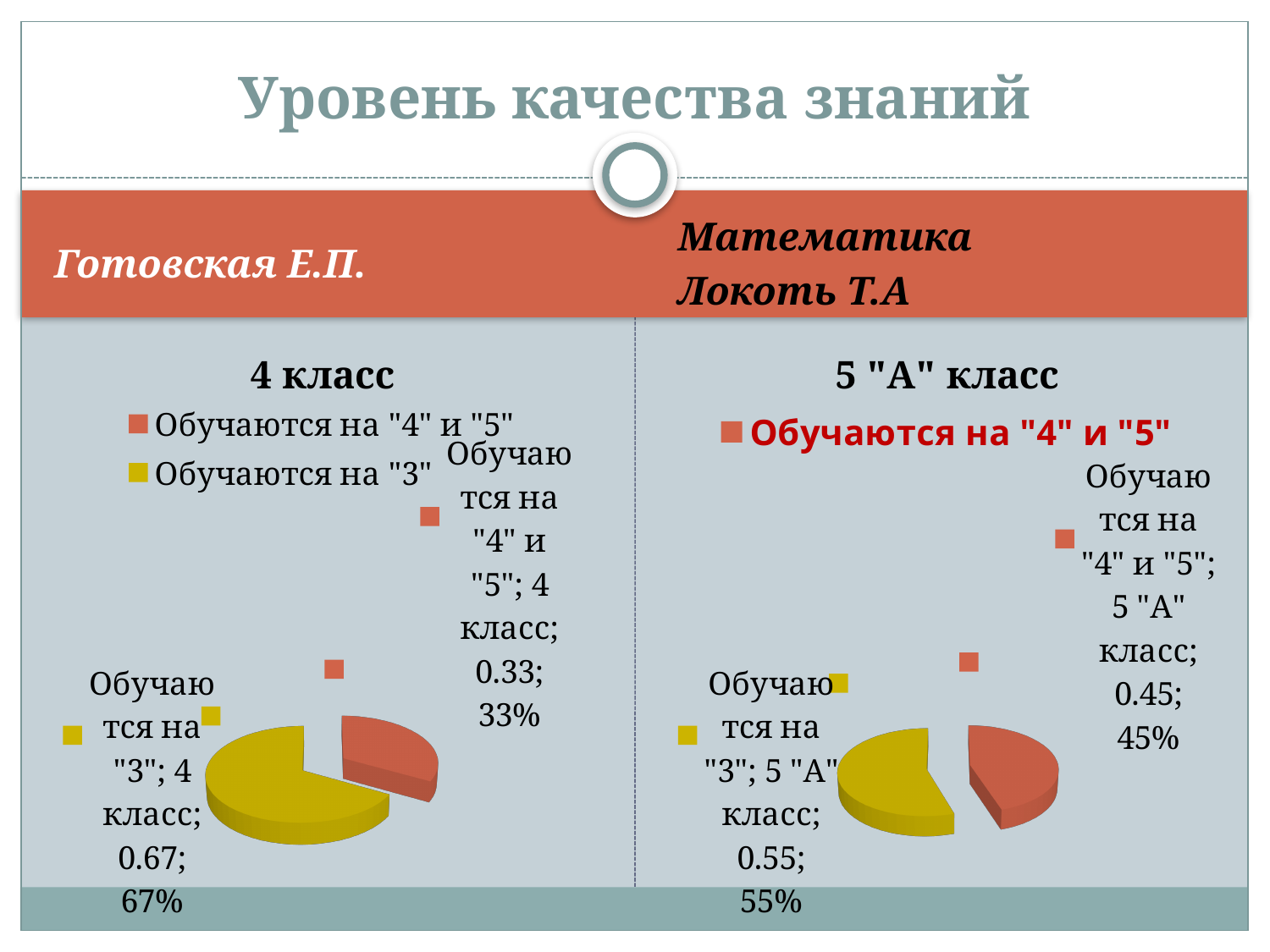
In the "5 "А" класс" chart, what share of the pie is labelled for Обучаются на "4" и "5"? 45% In the "5 "А" класс" chart, which slice is the smallest? Обучаются на "4" и "5" In the "4 класс" chart, what share of the pie is labelled for Обучаются на "4" и "5"? 33% In the "4 класс" chart, what is the difference in percentage points between the Обучаются на "3" slice and the Обучаются на "4" и "5" slice? 34% In the "4 класс" chart, what value is shown for Обучаются на "3"? 0.67 In the "4 класс" chart, what colour is the Обучаются на "3" slice? yellow How many slices does the "5 "А" класс" pie chart have? 2 What kind of chart is the "4 класс" chart? pie chart In the "5 "А" класс" chart, what value is shown for Обучаются на "3"? 0.55 In the "4 класс" chart, which slice is the largest? Обучаются на "3" In the "5 "А" класс" chart, what is the difference in percentage points between the Обучаются на "3" slice and the Обучаются на "4" и "5" slice? 10% Which chart has the larger share for Обучаются на "4" и "5": "4 класс" or "5 "А" класс"? 5 "А" класс